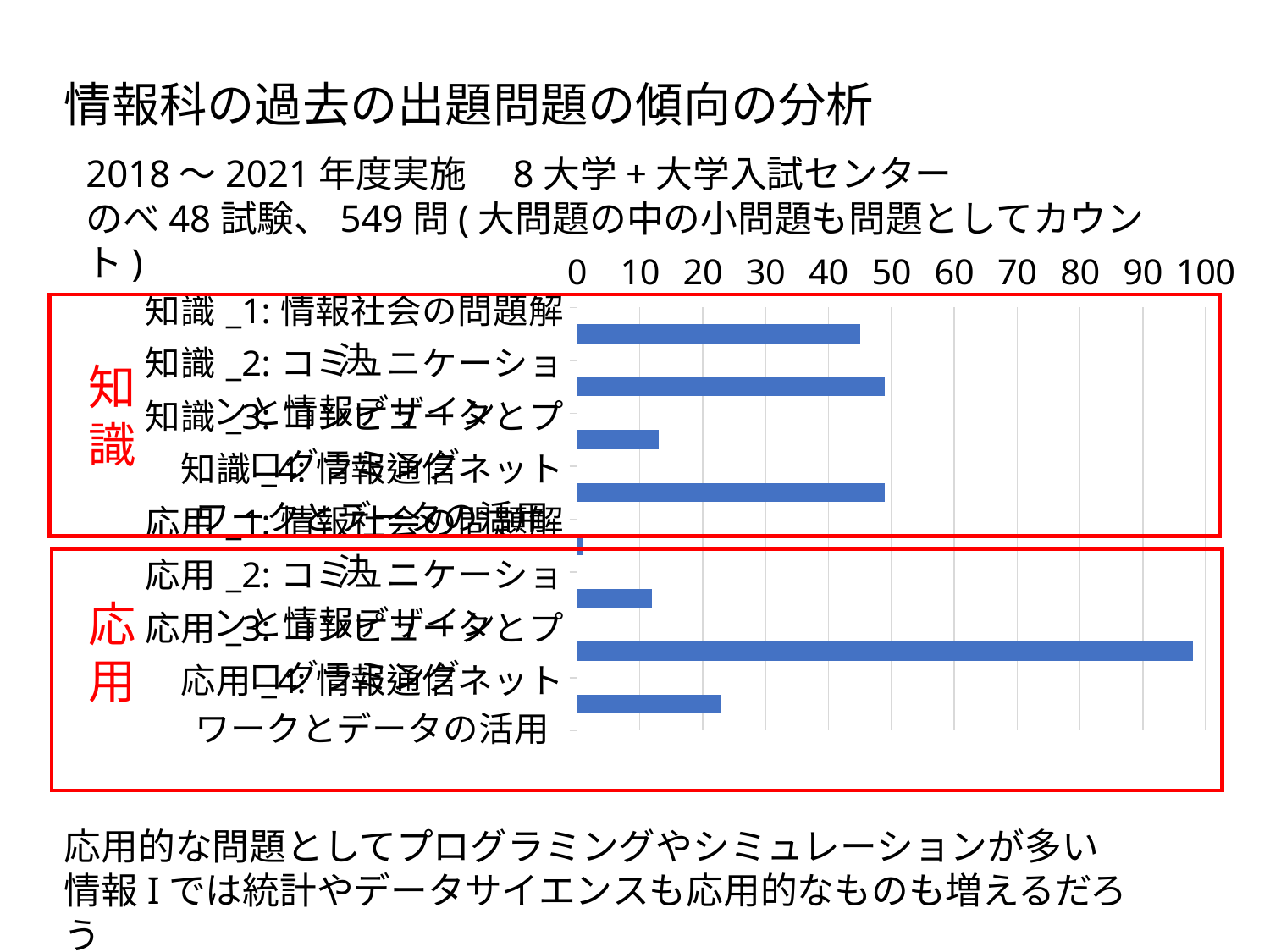
Which is larger, the value for 応用_3 or the value for 知識_2? 応用_3 What kind of chart is shown on the slide? bar chart How many categories (bars) does the chart show? 8 Is the value for 応用_4 greater or less than 30? less Which category has the longest bar in the chart? 応用_3 Which category has the shortest bar in the chart? 応用_1 Is the value for 知識_3 greater or less than 20? less Which is larger, the value for 知識_1 or the value for 応用_4? 知識_1 Is the value for 応用_3 greater or less than 90? greater What is the highest value shown on the chart's horizontal axis? 100